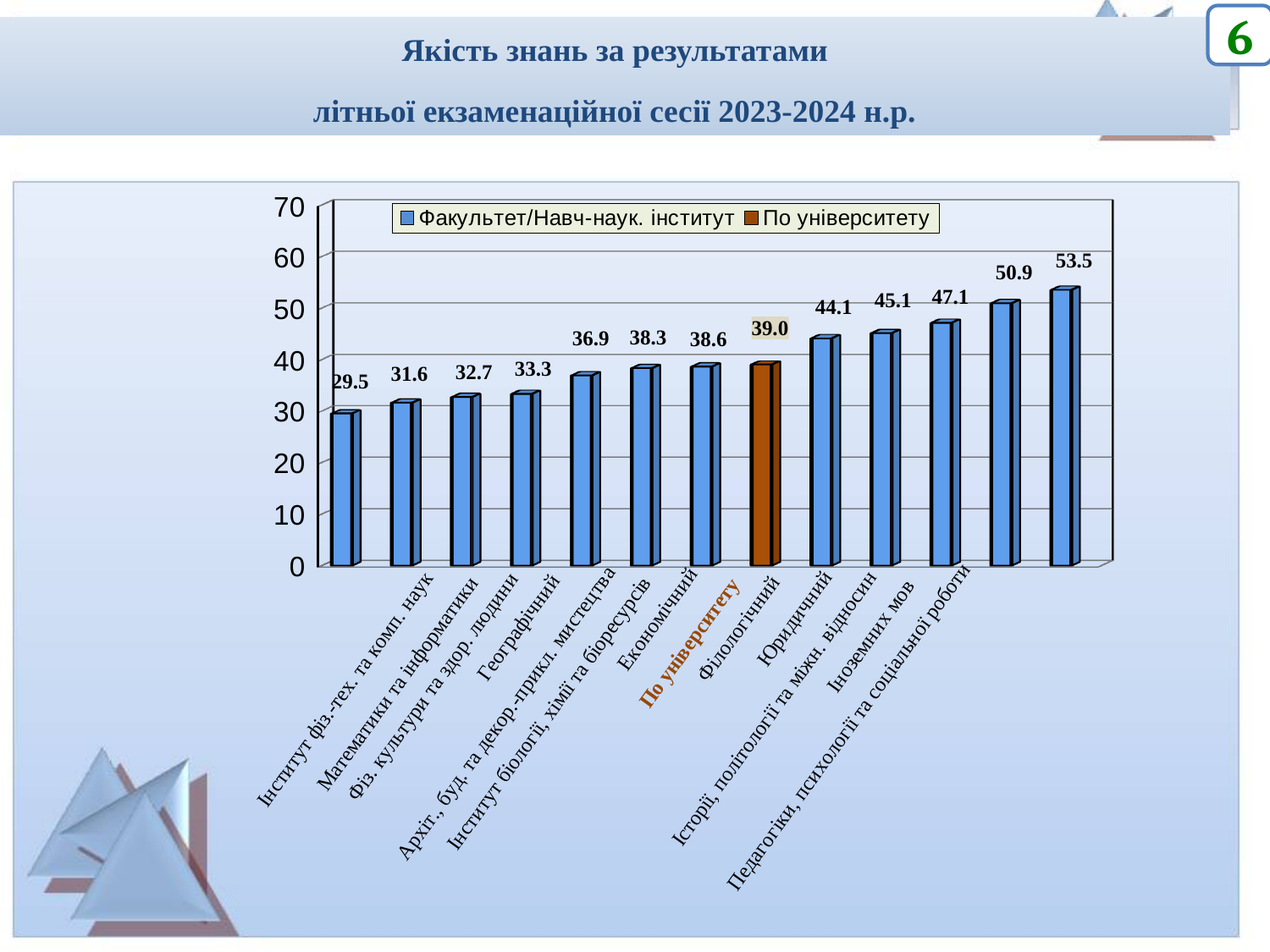
How many series does the legend list? 2 Which bar is shown in a different colour (brown) from the others? По університету How many bars are plotted in the chart? 13 Which is larger, the value for Економічний or the value for Філологічний? Філологічний Which category has the highest value? Педагогіки, психології та соціальної роботи What type of chart is shown on the slide? bar chart What is the difference between the values for Іноземних мов and Юридичний? 5.8 Which category has the lowest value? Інститут фіз.-тех. та комп. наук What is the value for Географічний? 33.3 What is the value for Педагогіки, психології та соціальної роботи? 53.5 What is the value for По університету? 39.0 Is the value for Історії, політології та міжн. відносин greater or less than 40? greater